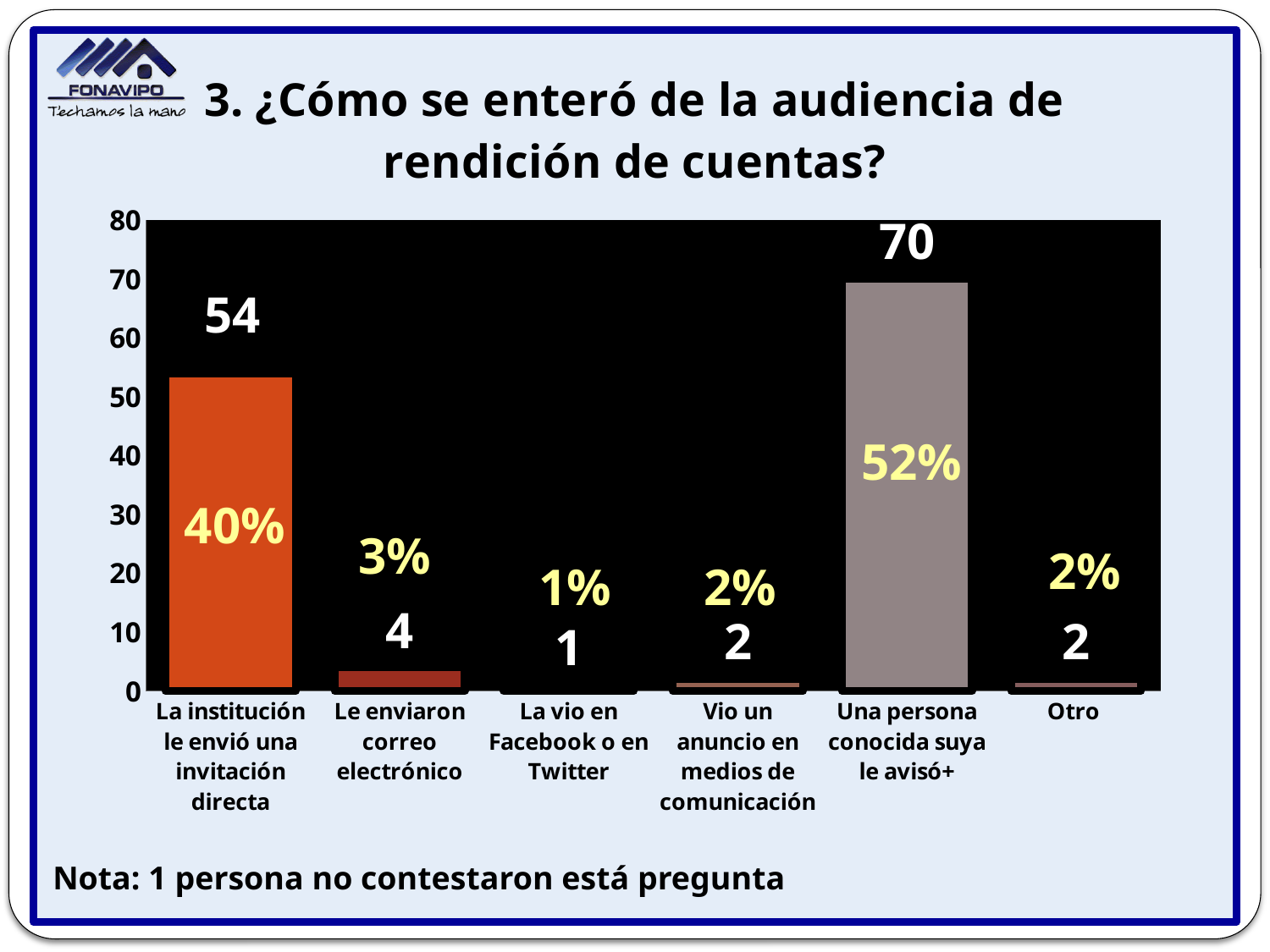
Which category has the highest value? Una persona conocida suya le avisó+ Which is larger, the value for "Le enviaron correo electrónico" or the value for "Otro"? Le enviaron correo electrónico What kind of chart is shown on the slide? bar chart What is the value for "Le enviaron correo electrónico"? 4 What percentage is shown for "La institución le envió una invitación directa"? 40% What percentage is shown for "Una persona conocida suya le avisó+"? 52% What is the value for "Una persona conocida suya le avisó+"? 70 Is the value for "La institución le envió una invitación directa" greater or less than 50? greater Which category has the lowest value? La vio en Facebook o en Twitter What is the value for "La institución le envió una invitación directa"? 54 What is the difference between the values for "Una persona conocida suya le avisó+" and "La institución le envió una invitación directa"? 16 How many categories are shown on the x axis? 6